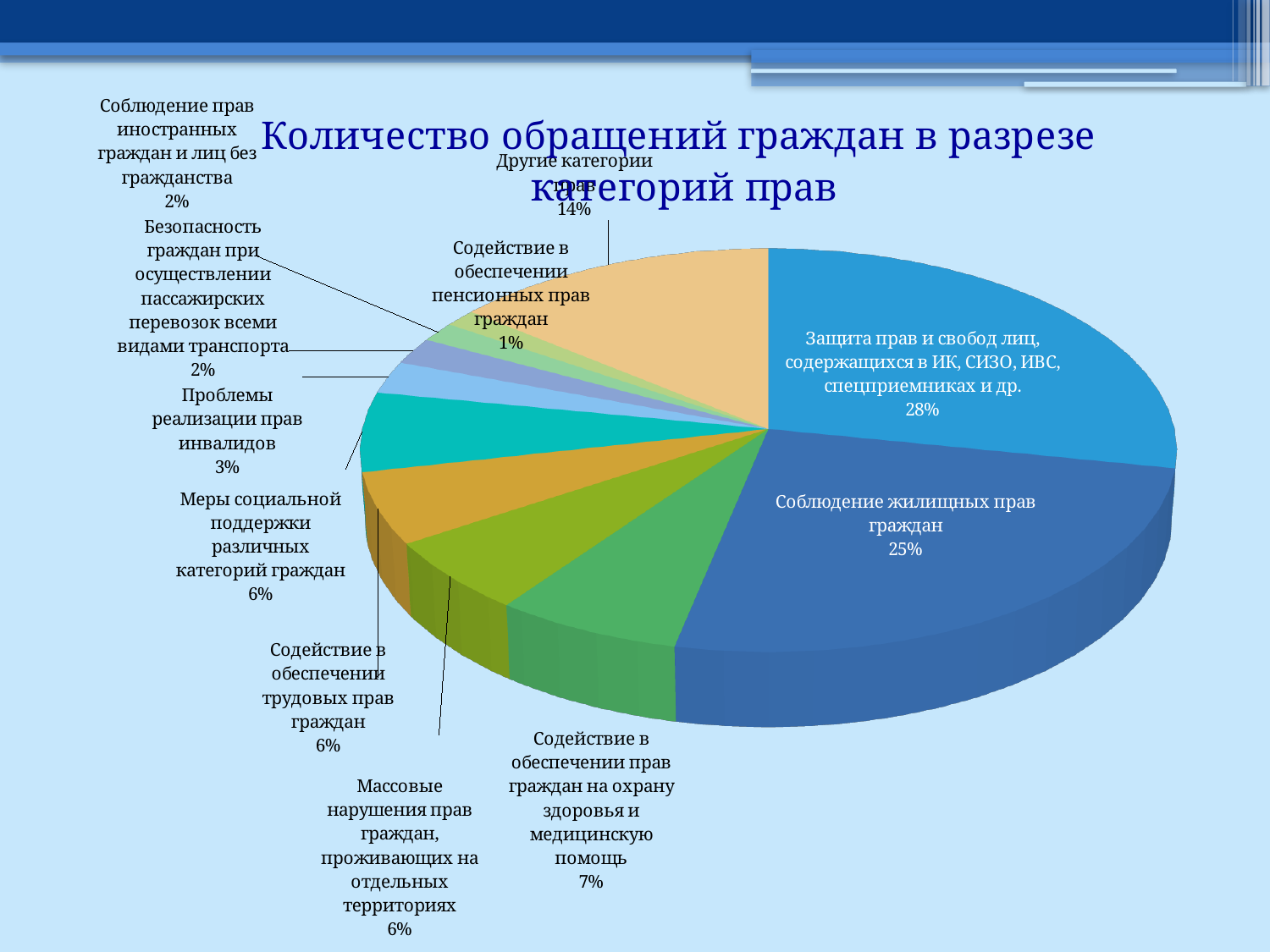
Which category has the smallest share of the pie? Содействие в обеспечении пенсионных прав граждан What percentage is shown for 'Другие категории прав'? 14% Which category has the largest share of the pie? Защита прав и свобод лиц, содержащихся в ИК, СИЗО, ИВС, спецприемниках и др. What percentage is shown for 'Содействие в обеспечении прав граждан на охрану здоровья и медицинскую помощь'? 7% What kind of chart is shown on the slide? pie chart What percentage is shown for 'Соблюдение прав иностранных граждан и лиц без гражданства'? 2% What is the difference in percentage points between 'Защита прав и свобод лиц, содержащихся в ИК, СИЗО, ИВС, спецприемниках и др.' and 'Соблюдение жилищных прав граждан'? 3 percentage points What share of the pie is 'Соблюдение жилищных прав граждан'? 25% Which is larger: the share for 'Другие категории прав' or the share for 'Содействие в обеспечении трудовых прав граждан'? Другие категории прав What percentage is shown for 'Проблемы реализации прав инвалидов'? 3% What is the title of the chart? Количество обращений граждан в разрезе категорий прав How many categories are shown in the pie chart? 11